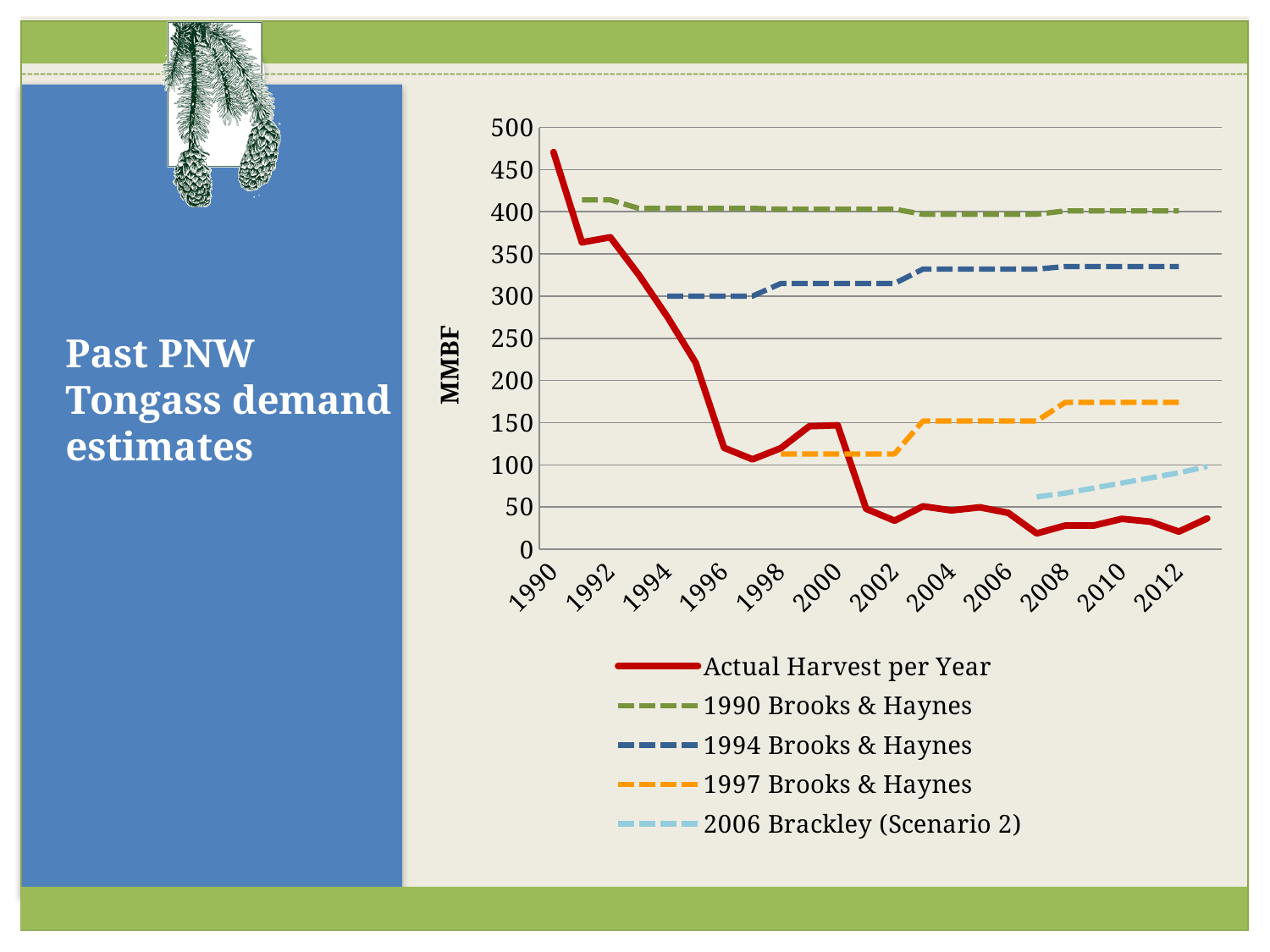
Is the value for 2006 Brackley (Scenario 2) in 2012 greater or less than 150? less Is the value for 1990 Brooks & Haynes in 2012 greater or less than 350? greater Which series has the highest value in 2012? 1990 Brooks & Haynes How many series does the legend list? 5 In 2012, which is larger: 1994 Brooks & Haynes or Actual Harvest per Year? 1994 Brooks & Haynes Does the Actual Harvest per Year series rise or fall overall from 1990 to 2012? fall Is the value for Actual Harvest per Year in 1990 greater or less than 450? greater What kind of chart is shown on the slide? line chart Which legend entry is drawn as a solid red line? Actual Harvest per Year What is the label on the vertical axis? MMBF